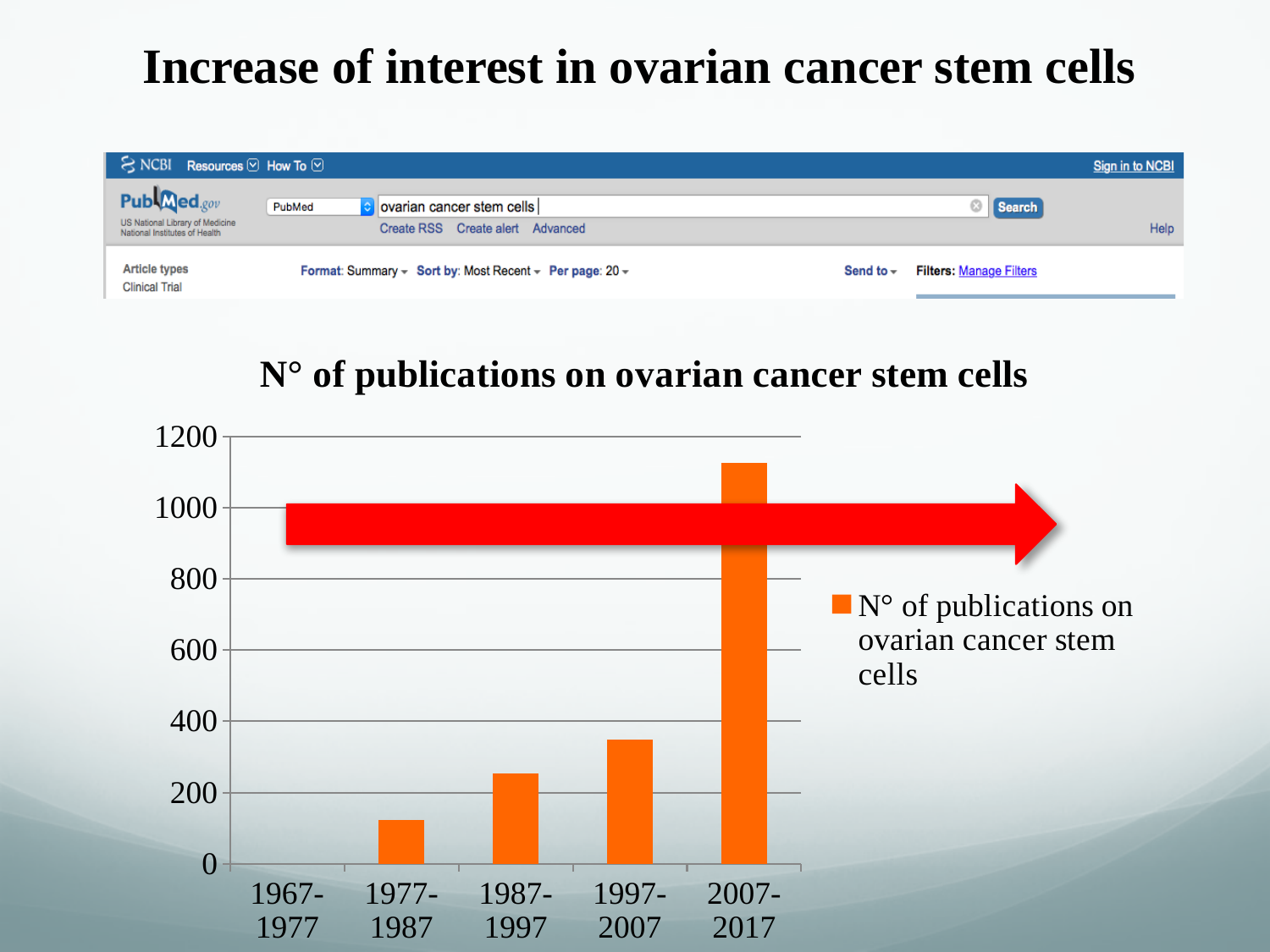
Which has more publications, 1977-1987 or 1987-1997? 1987-1997 Is the value for 1997-2007 greater or less than 400? less Is the value for 1977-1987 greater or less than 200? less How many series does the chart legend list? 1 What kind of chart is shown on the slide? bar chart What is the title of the chart? N° of publications on ovarian cancer stem cells Is the value for 2007-2017 greater or less than 1000? greater Which has more publications, 1997-2007 or 2007-2017? 2007-2017 Do the number of publications rise or fall across the time periods from 1967-1977 to 2007-2017? rise Which time period has the highest number of publications on ovarian cancer stem cells? 2007-2017 Which time period has the lowest number of publications on ovarian cancer stem cells? 1967-1977 How many time periods are shown on the x axis of the chart? 5